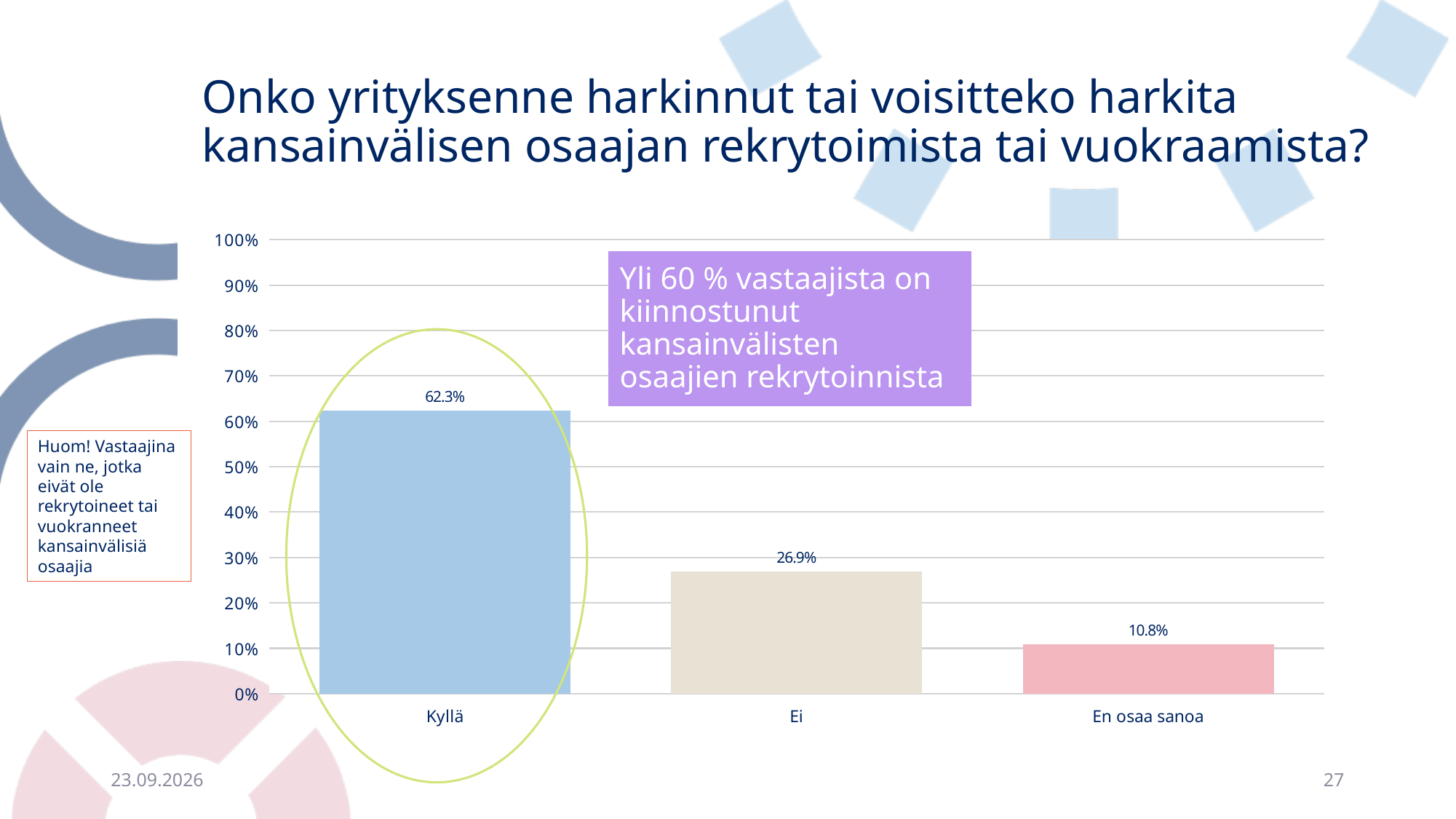
What is the difference between the values for Kyllä and Ei? 35.4% What is the value for Kyllä? 62.3% Which is larger, the value for Ei or the value for En osaa sanoa? Ei Which category has the lowest value? En osaa sanoa Which category has the highest value? Kyllä What is the difference between the values for Ei and En osaa sanoa? 16.1% What is the value for En osaa sanoa? 10.8% What kind of chart is shown on the slide? bar chart Is the value for Kyllä greater or less than 60%? greater Do the values rise or fall from left to right along the x axis? fall What is the value for Ei? 26.9% How many categories are shown on the x axis? 3